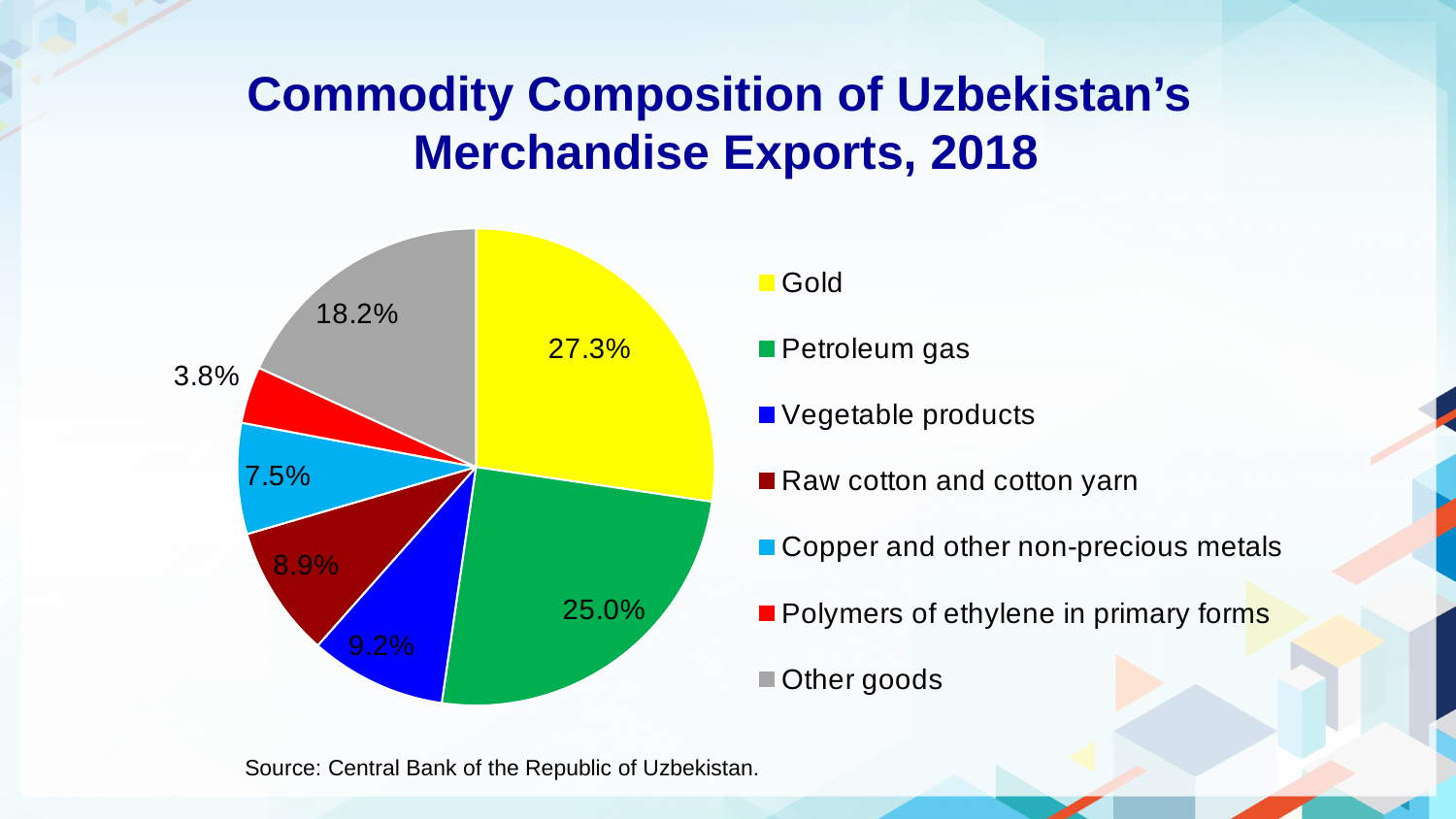
Which has a larger share of exports, vegetable products or copper and other non-precious metals? Vegetable products Which commodity category has the largest share of exports? Gold What share of exports was polymers of ethylene in primary forms? 3.8% Which commodity category has the smallest share of exports? Polymers of ethylene in primary forms What colour represents other goods in the pie chart? Grey What share of exports was petroleum gas? 25.0% What is the combined share of gold and petroleum gas? 52.3% How many categories does the pie chart show? 7 What share of exports was raw cotton and cotton yarn? 8.9% What is the difference in percentage points between the gold share and the petroleum gas share? 2.3 What share of Uzbekistan's merchandise exports in 2018 was gold? 27.3% What kind of chart is shown on the slide? pie chart